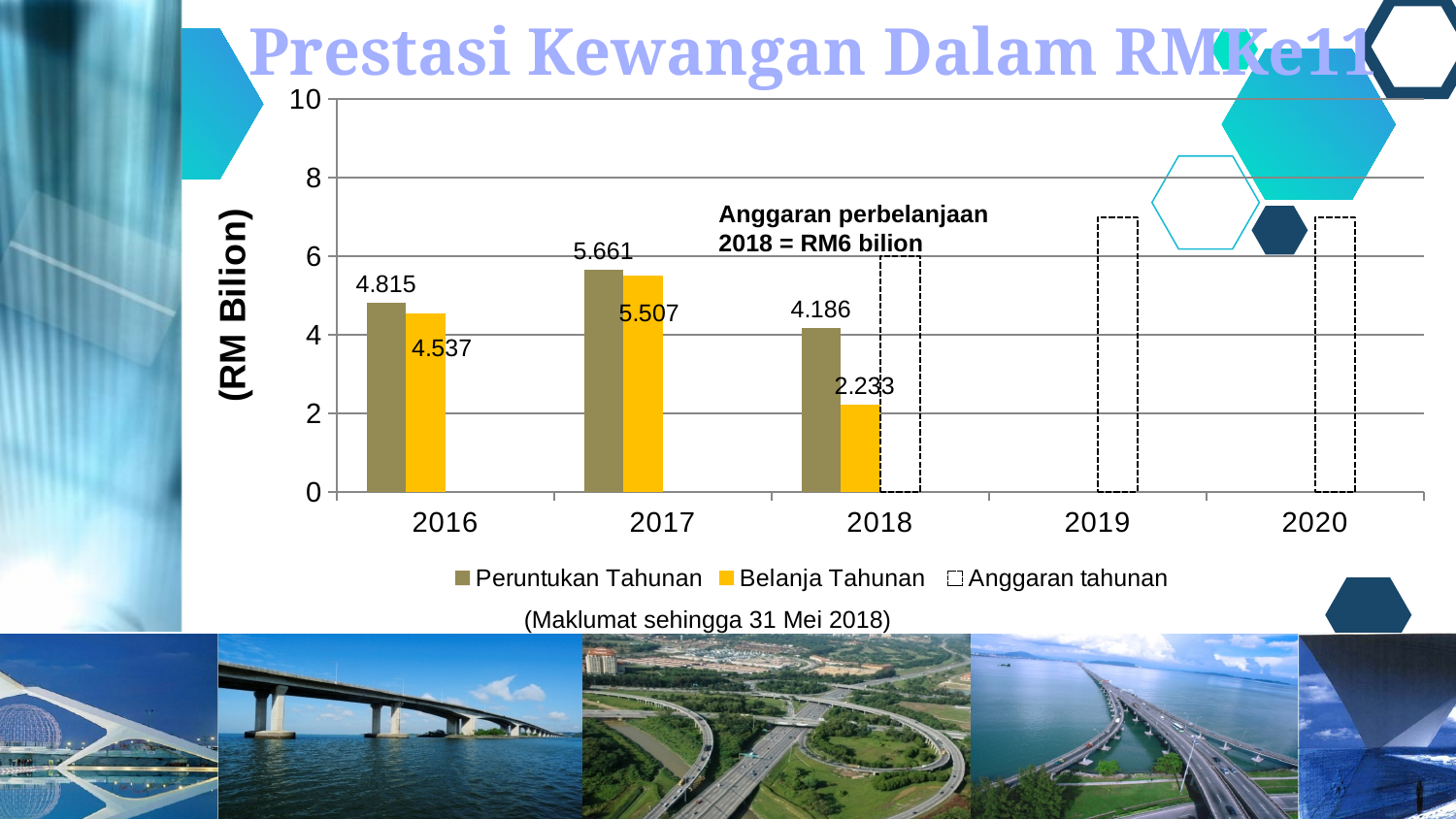
How many series does the legend list? 3 Which is larger in 2016, Peruntukan Tahunan or Belanja Tahunan? Peruntukan Tahunan Which year has the highest Peruntukan Tahunan value? 2017 How many years are shown on the x axis? 5 Is the Anggaran tahunan value for 2019 greater or less than 6? greater What is the label of the vertical axis? (RM Bilion) What is the Belanja Tahunan value for 2016? 4.537 What kind of chart is shown on the slide? bar chart What is the Belanja Tahunan value for 2018? 2.233 Which year has the lowest Belanja Tahunan value? 2018 What is the difference between Peruntukan Tahunan and Belanja Tahunan in 2018? 1.953 What is the Peruntukan Tahunan value for 2017? 5.661